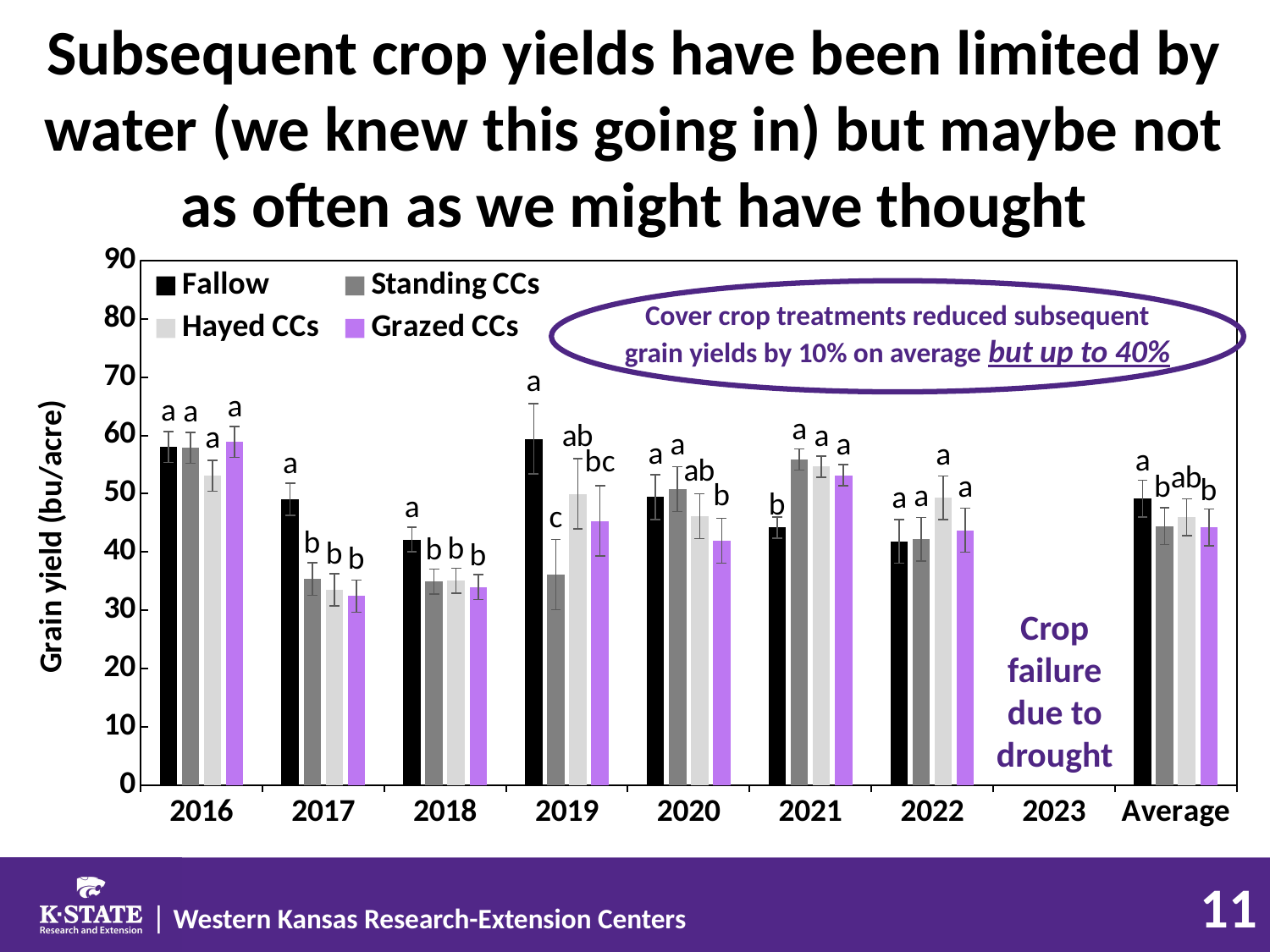
In 2017, which is larger, the Fallow value or the Standing CCs value? Fallow Is the Fallow value for 2021 greater or less than 50? less Which series has the highest value in 2017? Fallow Is the Standing CCs value for 2017 greater or less than 40? less How many series does the legend list? 4 Is the Fallow value for 2016 greater or less than 50? greater How many categories are labelled along the x axis? 9 What kind of chart is shown on the slide? bar chart In 2021, which is larger, the Fallow value or the Standing CCs value? Standing CCs Which series has the lowest value in 2019? Standing CCs Which year on the x axis has no bars because of crop failure due to drought? 2023